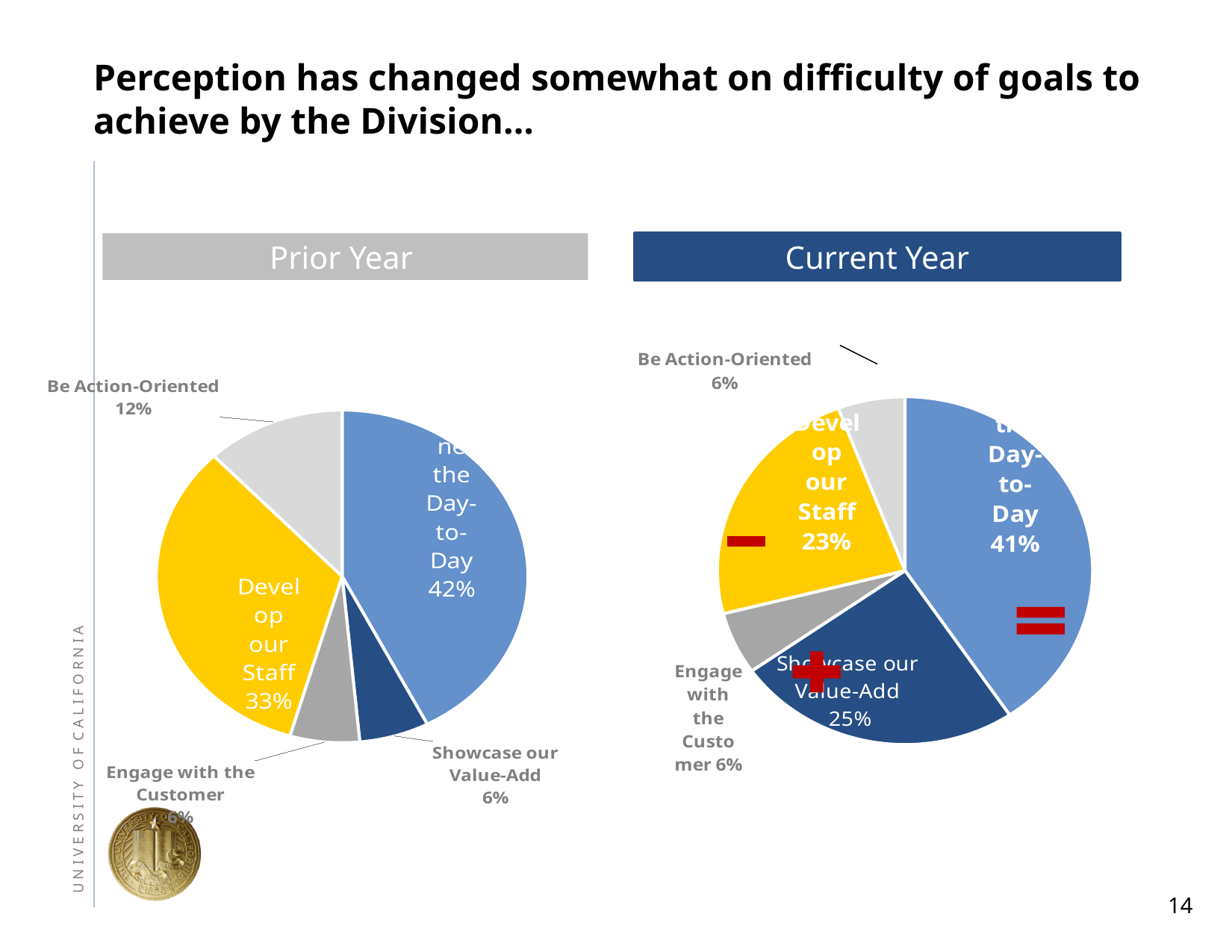
In the Current Year pie chart, which category has the largest slice? Day-to-Day In the Prior Year pie chart, what share is labelled for Showcase our Value-Add? 6% What is the difference between the Develop our Staff share in the Prior Year chart and in the Current Year chart? 10% Which is larger: Showcase our Value-Add in the Prior Year chart or in the Current Year chart? Current Year In the Current Year pie chart, what share is labelled for Develop our Staff? 23% What type of chart is used for the Prior Year data? Pie chart In the Prior Year pie chart, what share is labelled for Develop our Staff? 33% In the Prior Year pie chart, what is the percentage shown on the largest slice? 42% How many slices does the Current Year pie chart have? 5 In the Current Year pie chart, what share is labelled for Showcase our Value-Add? 25% In the Prior Year pie chart, what share is labelled for Be Action-Oriented? 12% In the Current Year pie chart, what share is labelled for Engage with the Customer? 6%